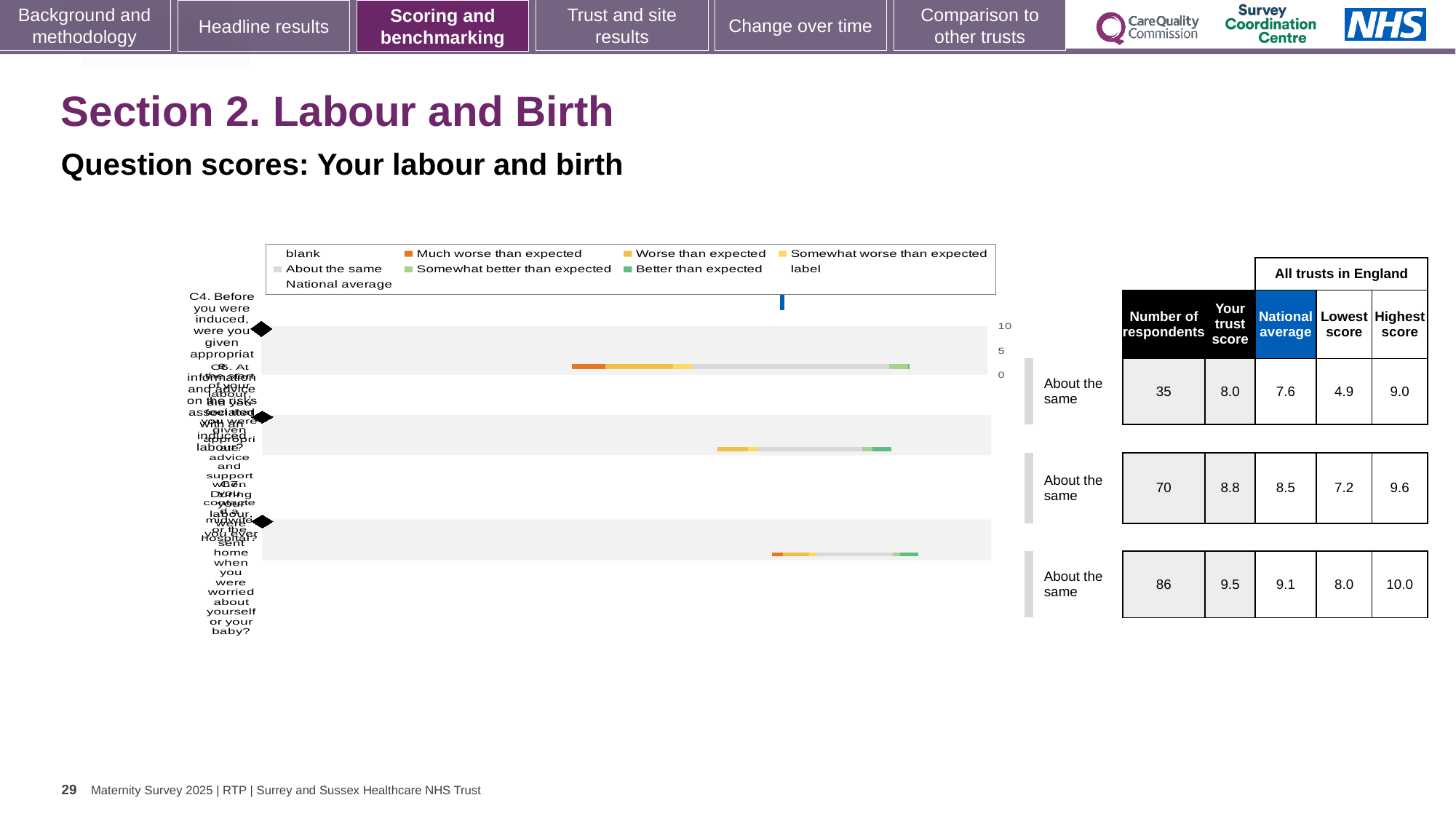
How many question rows (bars) are plotted in the chart? 3 In the table beside the chart, what is the number of respondents for the bottom row? 86 What colour does the legend use for 'Much worse than expected'? orange For the bottom row, what is the difference between 'Your trust score' and the 'National average'? 0.4 In the table beside the chart, what is the 'Your trust score' for the top row? 8.0 What kind of chart is shown on the slide? bar chart How many more respondents does the bottom row have than the top row? 51 What is the 'Highest score' among all trusts in England for the middle row? 9.6 For the top row, which is larger: 'Your trust score' or the 'National average'? Your trust score (8.0) What is the 'Lowest score' among all trusts in England for the top row? 4.9 Which row in the table has the highest 'Your trust score'? the bottom row (9.5) What benchmark category is shown next to each of the three bars? About the same